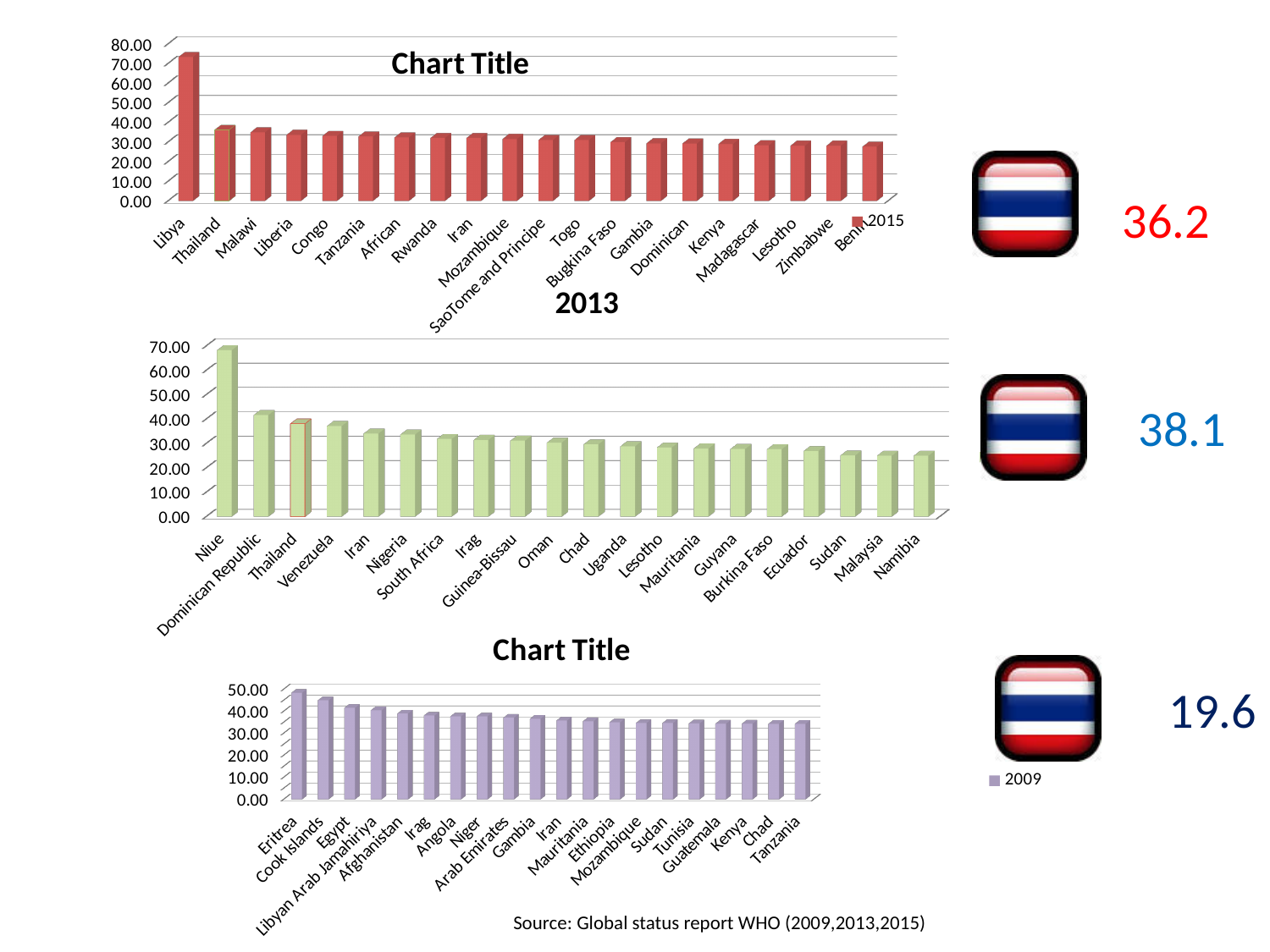
In the middle chart titled 2013, is the value for Thailand greater or less than 30.00? greater What kind of chart is the bottom chart (legend 2009)? bar chart In the top chart (legend 2015), how many countries are plotted? 20 In the bottom chart (legend 2009), which country has the highest value? Eritrea In the top chart (legend 2015), is the value for Libya greater or less than 60.00? greater In the top chart (legend 2015), is the value for Benin greater or less than 30.00? less In the top chart (legend 2015), which country has the lowest value? Benin In the top chart (legend 2015), which country has the highest value? Libya In the middle chart titled 2013, which country has the lowest value? Malaysia and Namibia (tied) In the middle chart titled 2013, which country has the highest value? Niue In the middle chart titled 2013, do the values rise or fall from left to right along the x axis? fall